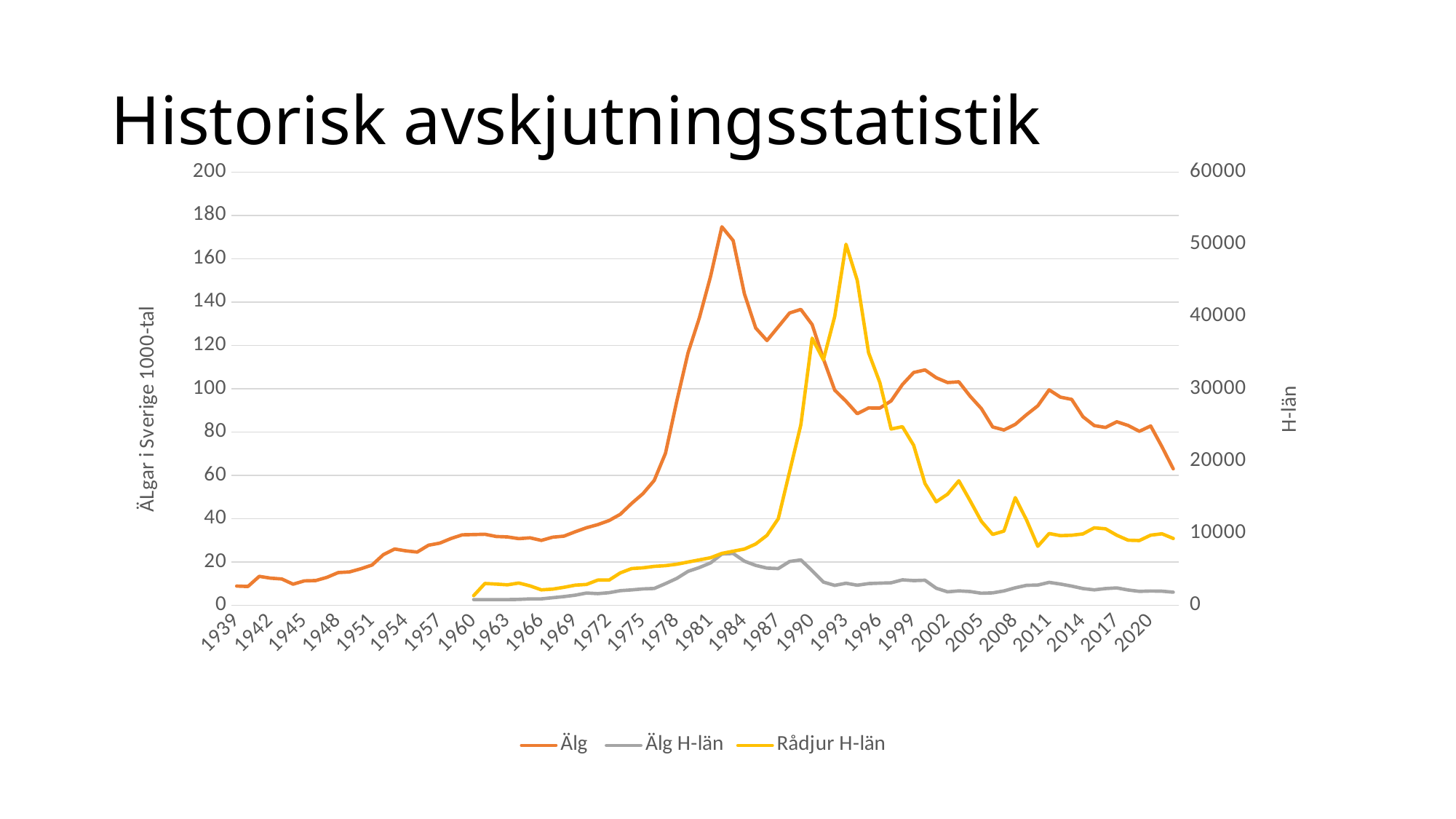
Is the value for Älg in 1939 greater or less than 20? less What kind of chart is shown on the slide? line chart Does the Rådjur H-län series rise or fall between 1993 and 2020? fall Does the Älg series rise or fall between 1939 and 1981? rise Is the value for Älg in 1960 greater or less than 20? greater Which series reaches a higher peak on the right axis, Älg H-län or Rådjur H-län? Rådjur H-län Is the peak value of the Älg series greater or less than 160? greater How many series does the legend list? 3 What is the title of the chart? Historisk avskjutningsstatistik What is the label of the left vertical axis? ÄLgar i Sverige 1000-tal